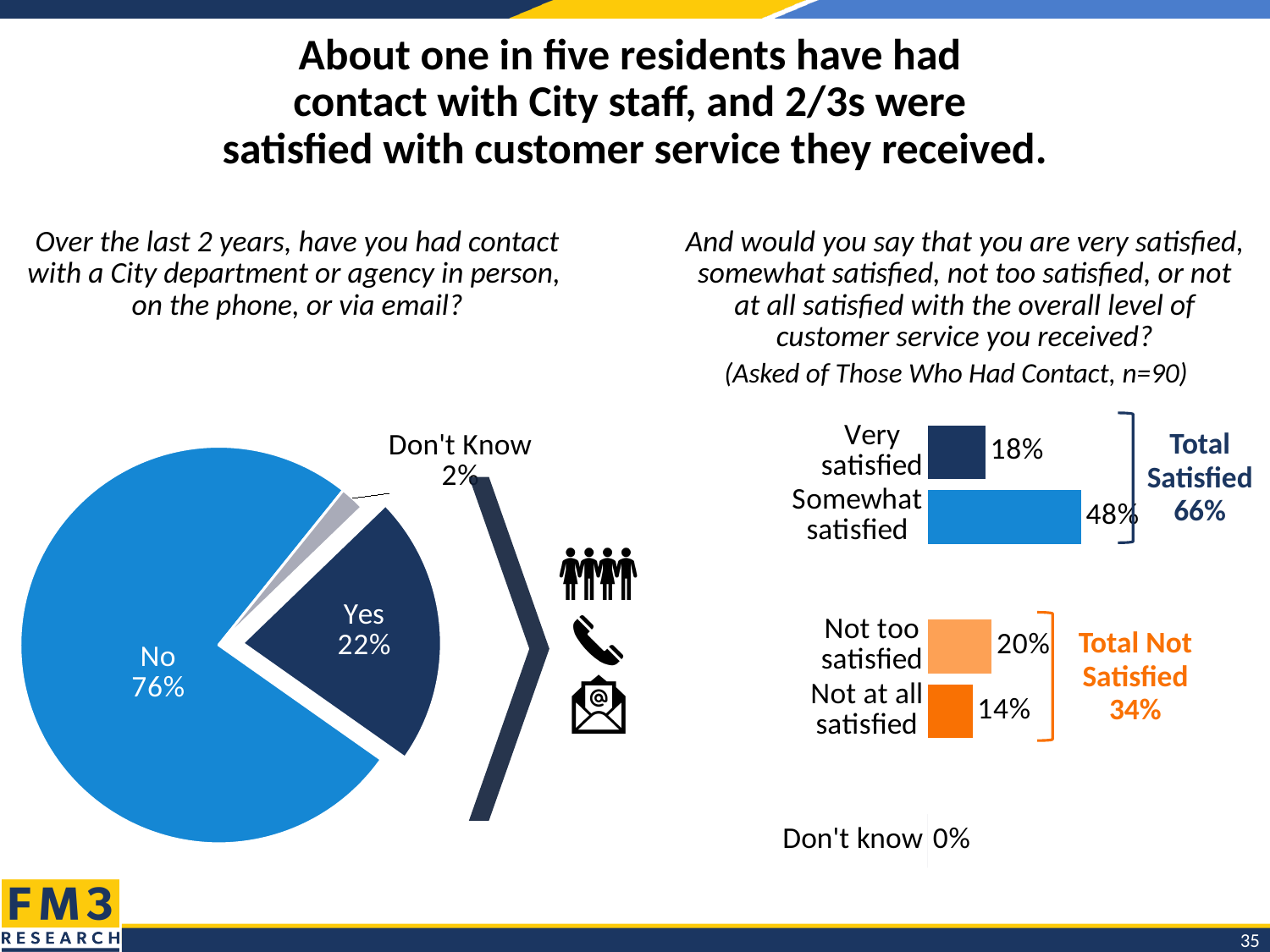
In the bar chart on the right, which response has the highest percentage? Somewhat satisfied In the pie chart on the left, which response has the smallest slice? Don't Know In the pie chart on the left, what is the difference between the "No" and "Yes" percentages? 54 percentage points In the bar chart on the right, what is the combined "Total Satisfied" percentage shown? 66% What kind of chart is on the right side of the slide? Bar chart In the pie chart on the left, what percentage of residents answered "No" to having had contact with a City department? 76% In the bar chart on the right, what percentage said they were "Somewhat satisfied"? 48% What kind of chart is on the left side of the slide? Pie chart In the bar chart on the right, what percentage said they were "Not at all satisfied"? 14% In the pie chart on the left, what share of residents answered "Yes"? 22% In the pie chart on the left, how many slices are shown? 3 In the bar chart on the right, which is larger: "Very satisfied" or "Not too satisfied"? Not too satisfied